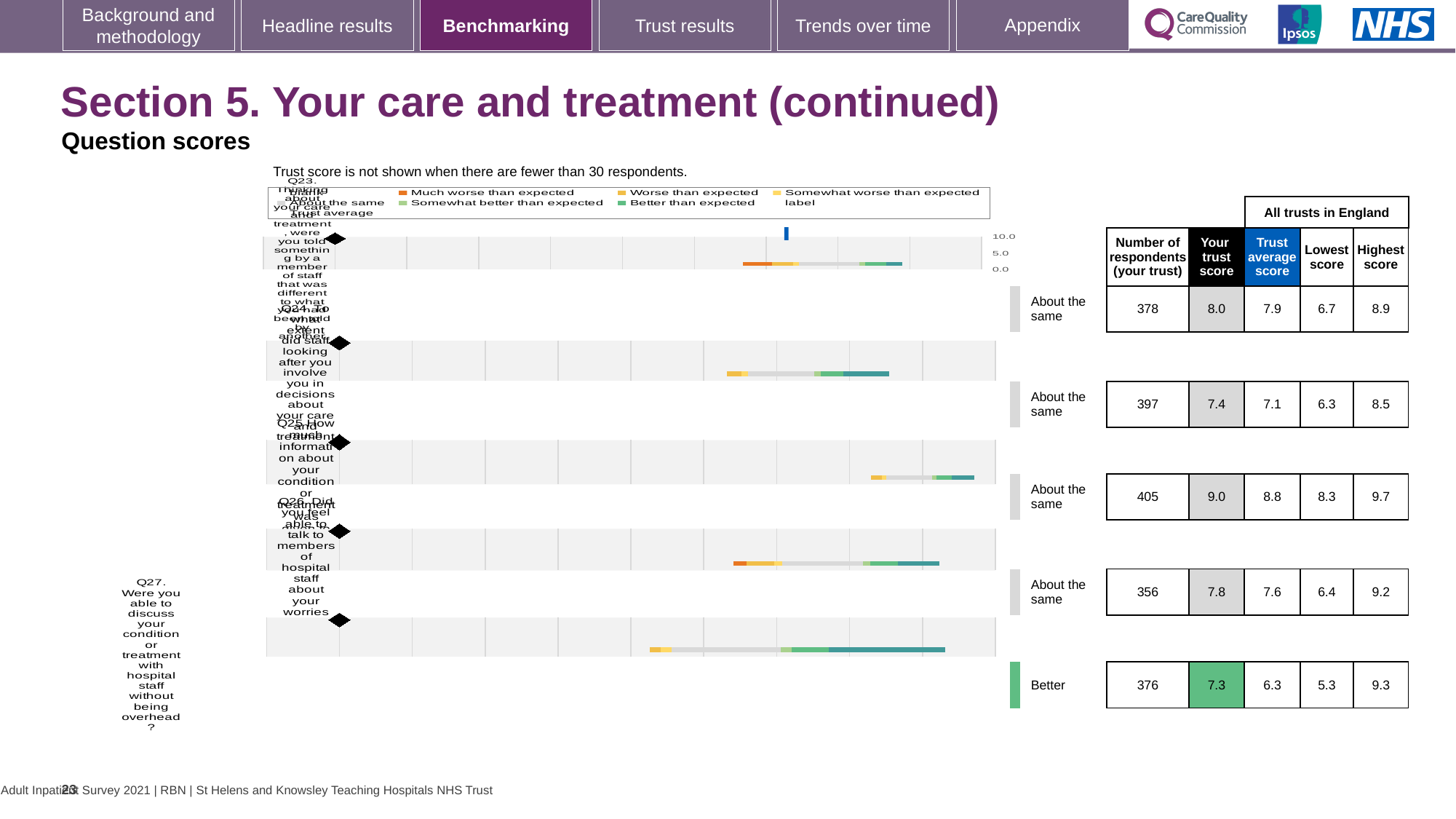
What is the lowest score across all trusts in England for Q27? 5.3 What is the 'Your trust score' for Q27 (discussing your condition or treatment without being overheard)? 7.3 Which question is rated 'Better' rather than 'About the same' compared with other trusts? Q27 How many questions are shown on this slide? 5 Which question has the lowest 'Your trust score' on this slide? Q27 How many respondents answered Q24 for this trust? 397 What is the highest score across all trusts in England for Q25? 9.7 How many respondents answered Q23 for this trust? 378 Which question has the highest 'Your trust score' on this slide? Q25 For Q26, which is larger: the trust score or the trust average score? Trust score (7.8) What is the difference between the trust score and the trust average score for Q24? 0.3 What is the trust average score for Q26? 7.6